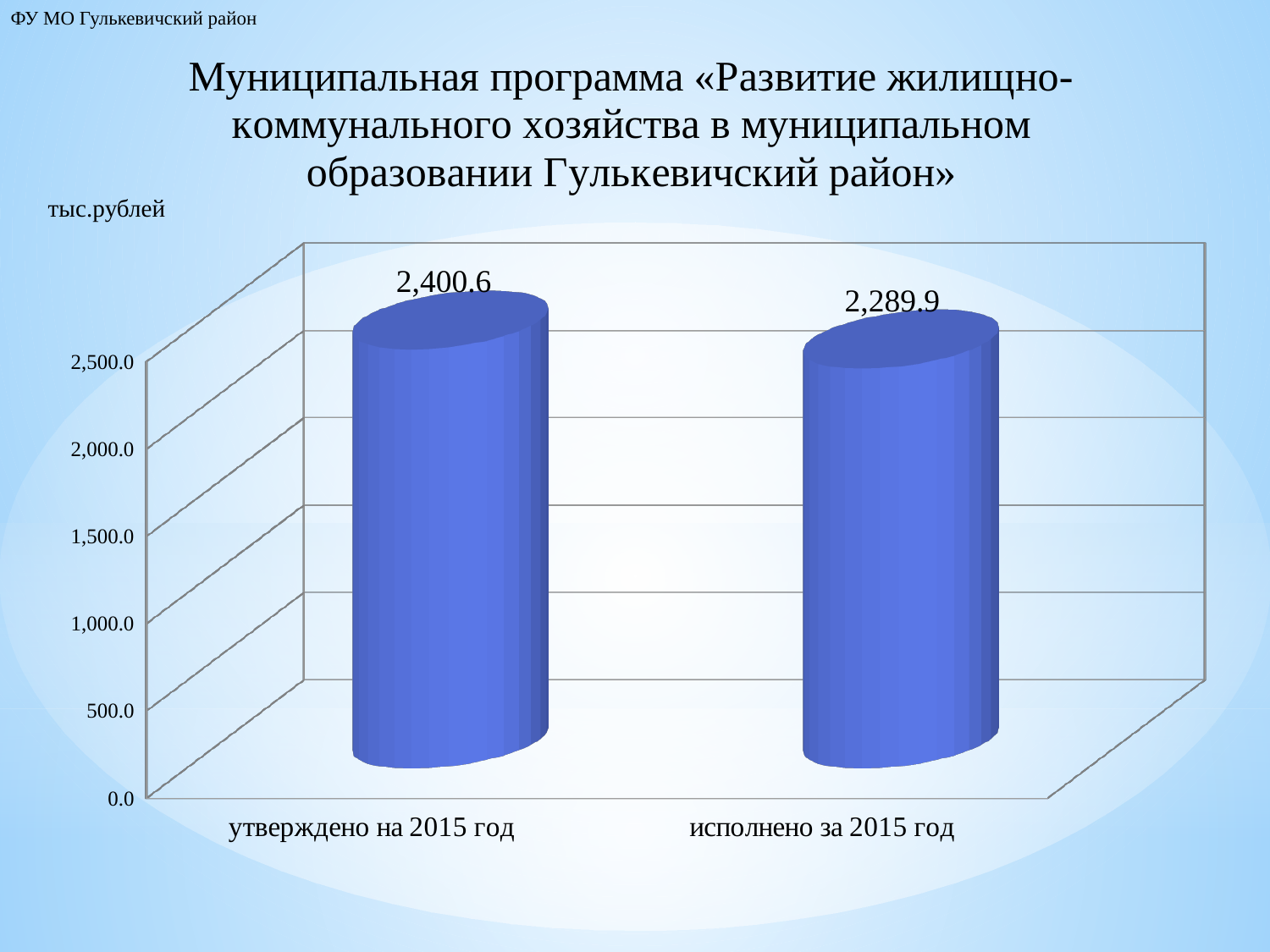
What unit of measurement is indicated above the chart? тыс.рублей What is the value for «исполнено за 2015 год»? 2,289.9 Do the values rise or fall from the first category to the second? fall Which category has the lowest value? исполнено за 2015 год Which is larger: the value for «утверждено на 2015 год» or the value for «исполнено за 2015 год»? утверждено на 2015 год Which category has the highest value? утверждено на 2015 год How many categories are shown on the chart? 2 Is the value for «исполнено за 2015 год» greater or less than 2,000.0? greater Is the value for «утверждено на 2015 год» greater or less than 1,500.0? greater What kind of chart is shown on the slide? bar chart What is the difference between the value for «утверждено на 2015 год» and the value for «исполнено за 2015 год»? 110.7 What is the value for «утверждено на 2015 год»? 2,400.6